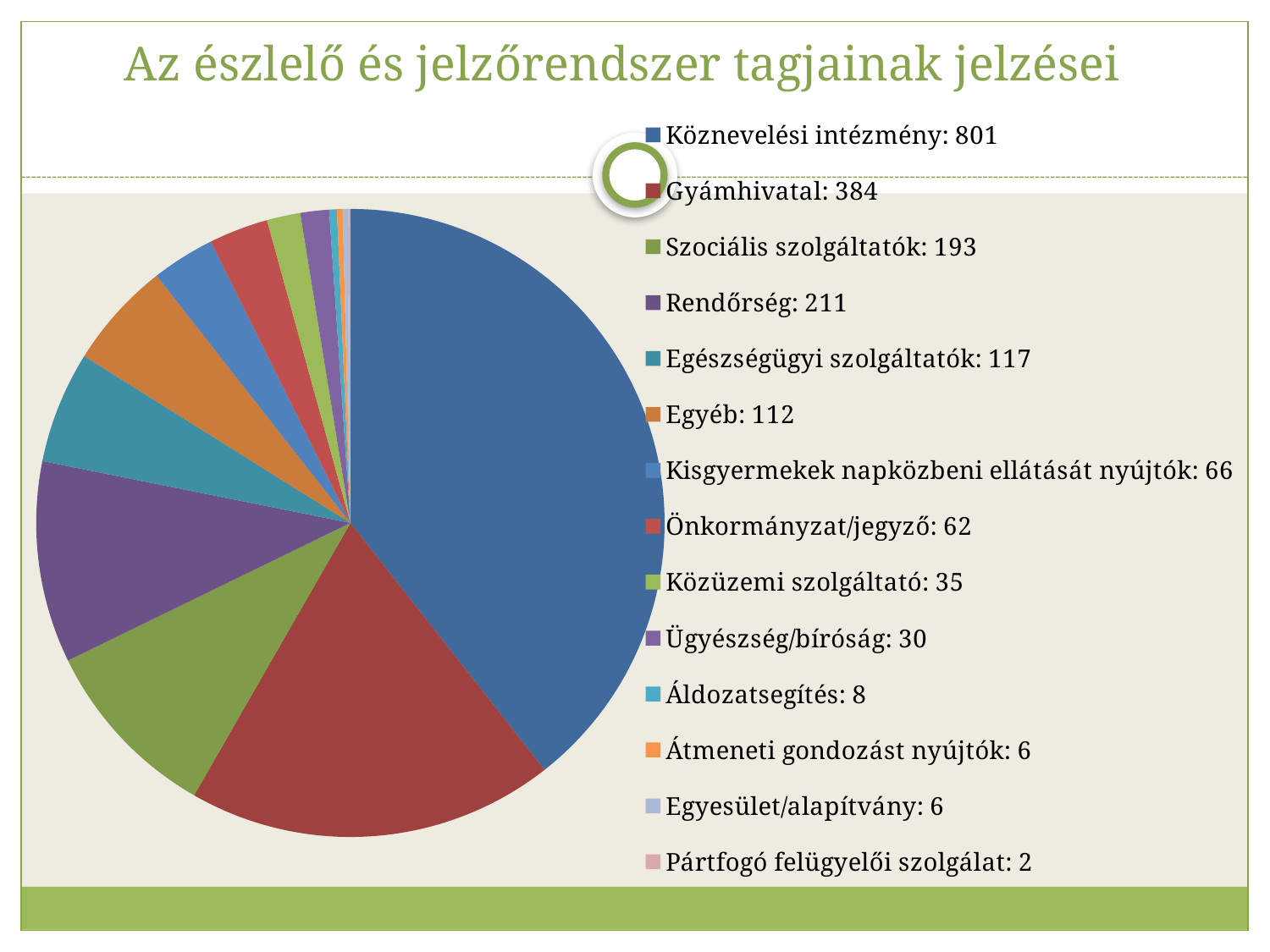
What is the title of the slide? Az észlelő és jelzőrendszer tagjainak jelzései What is the value for Kisgyermekek napközbeni ellátását nyújtók? 66 Which category has the lowest value? Pártfogó felügyelői szolgálat What is the difference between the values for Köznevelési intézmény and Gyámhivatal? 417 What is the value for Köznevelési intézmény? 801 How many categories does the pie chart have? 14 What is the value for Egészségügyi szolgáltatók? 117 What is the value for Gyámhivatal? 384 Which category has the highest value? Köznevelési intézmény What kind of chart is shown on the slide? pie chart What is the value for Ügyészség/bíróság? 30 Which is larger, the value for Rendőrség or the value for Szociális szolgáltatók? Rendőrség